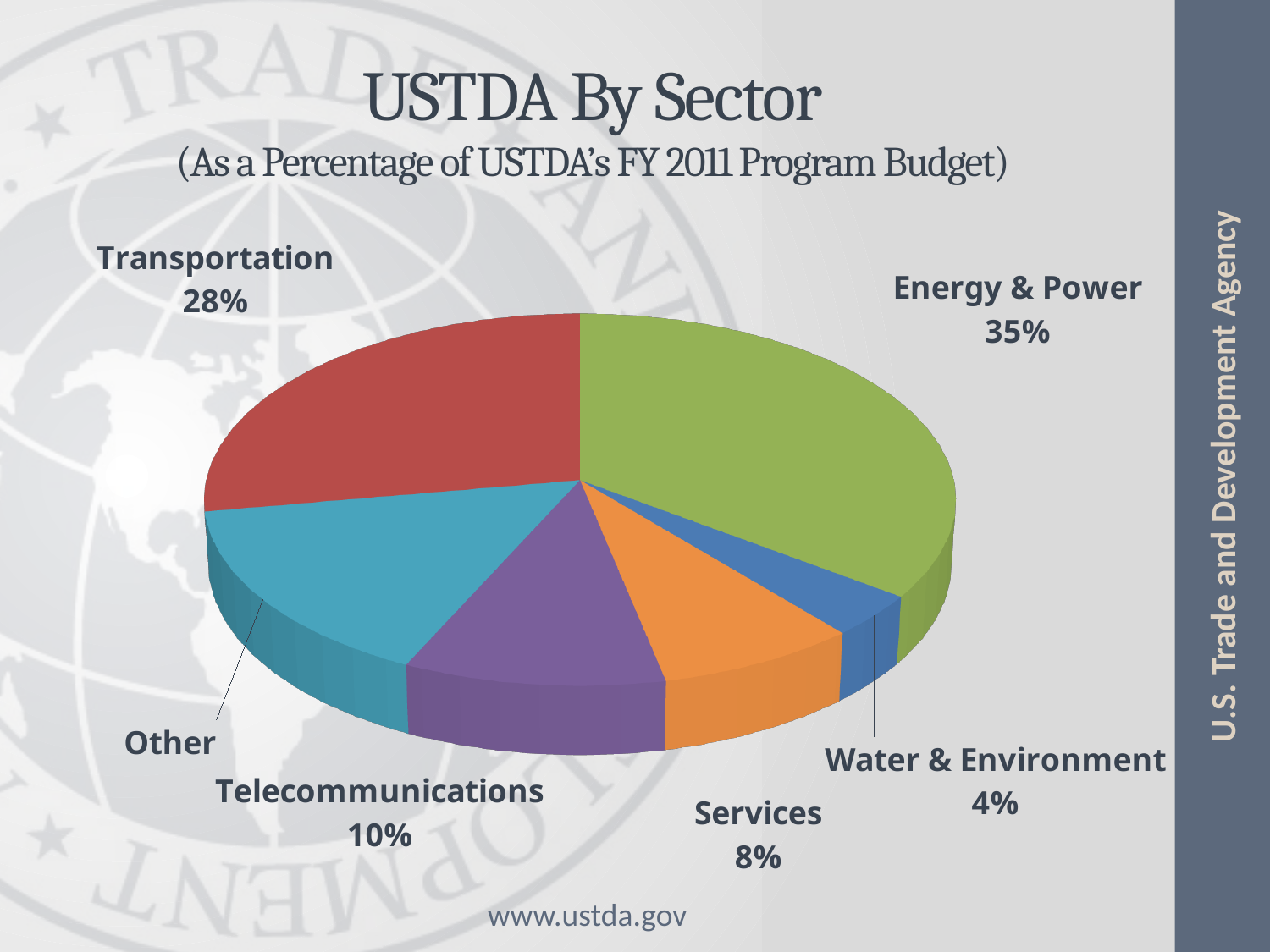
What type of chart is shown on the slide? Pie chart Which sector has the largest share of the budget? Energy & Power Which sector has the smallest share of the budget? Water & Environment What percentage is shown for Telecommunications? 10% What percentage is shown for Water & Environment? 4% What is the difference in percentage points between Energy & Power and Transportation? 7 percentage points What is the title of the chart? USTDA By Sector What percentage is shown for Transportation? 28% What percentage of USTDA's FY 2011 program budget went to Energy & Power? 35% How many sectors (slices) are shown in the pie chart? 6 What percentage is shown for Services? 8% Which is larger, the share for Services or the share for Telecommunications? Telecommunications